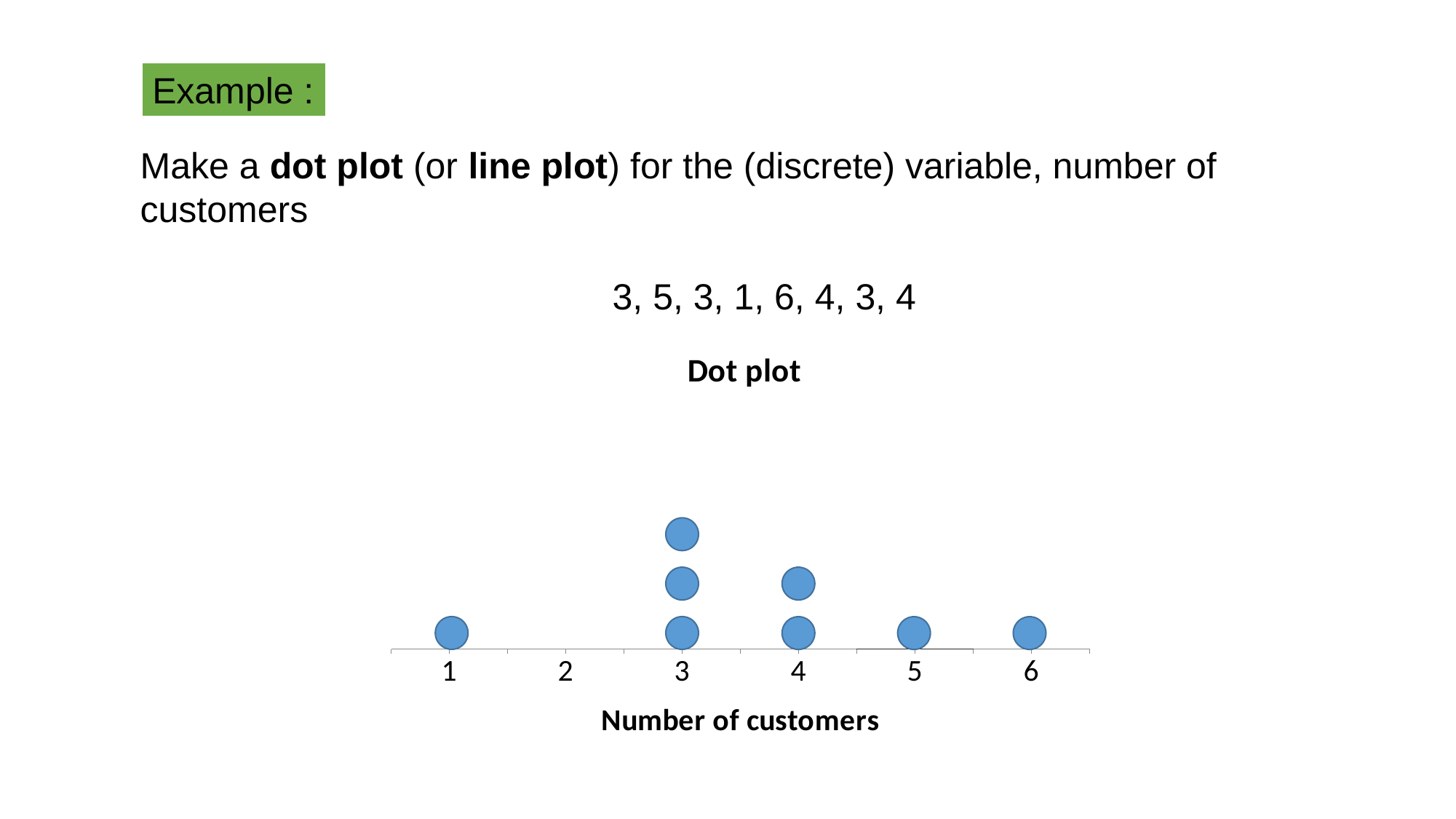
What is the title of the chart? Dot plot How many dots are plotted above the value 4 on the x axis? 2 Which value on the x axis has the most dots? 3 Which has more dots, the value 4 or the value 5? 4 How many more dots are above 3 than above 4? 1 How many dots are plotted above the value 2 on the x axis? 0 How many values are labelled on the x axis of the chart? 6 What is the label on the x axis of the chart? Number of customers Which value on the x axis has no dots at all? 2 How many dots are plotted above the value 3 on the x axis? 3 What kind of chart is shown on the slide? dot plot How many dots are plotted above the value 1 on the x axis? 1